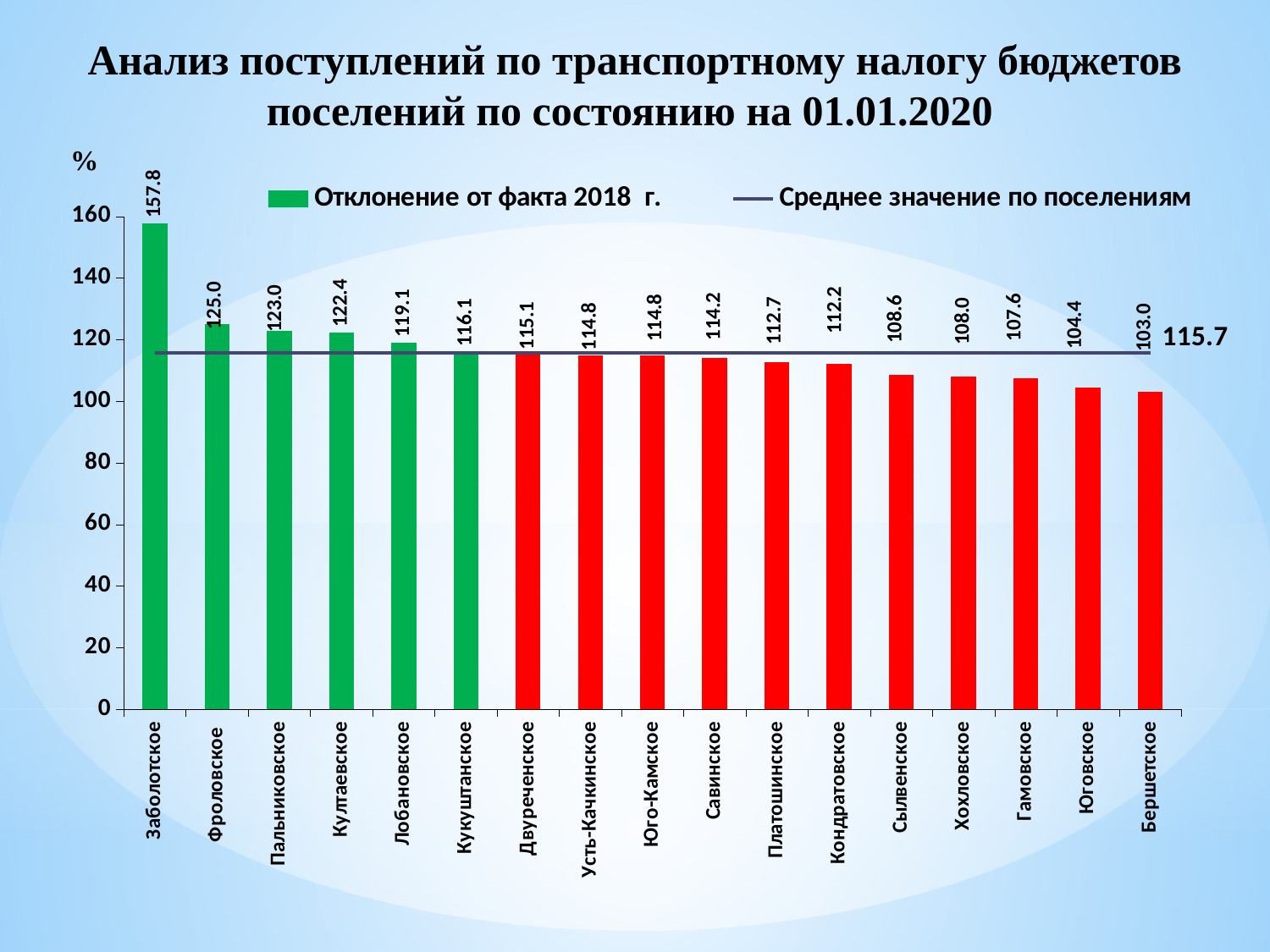
What kind of chart is shown on the slide? Bar chart What is the value of the average line (Среднее значение по поселениям)? 115.7 What is the value for Заболотское? 157.8 What is the difference between the values for Заболотское and Фроловское? 32.8 What is the value for Бершетское? 103.0 Which is larger, the value for Лобановское or the value for Сылвенское? Лобановское Do the bar values rise or fall from left to right along the x axis? Fall How many settlements are shown on the x axis? 17 What is the value for Кукуштанское? 116.1 How many entries does the legend list? 2 Which settlement has the highest value? Заболотское Which settlement has the lowest value? Бершетское